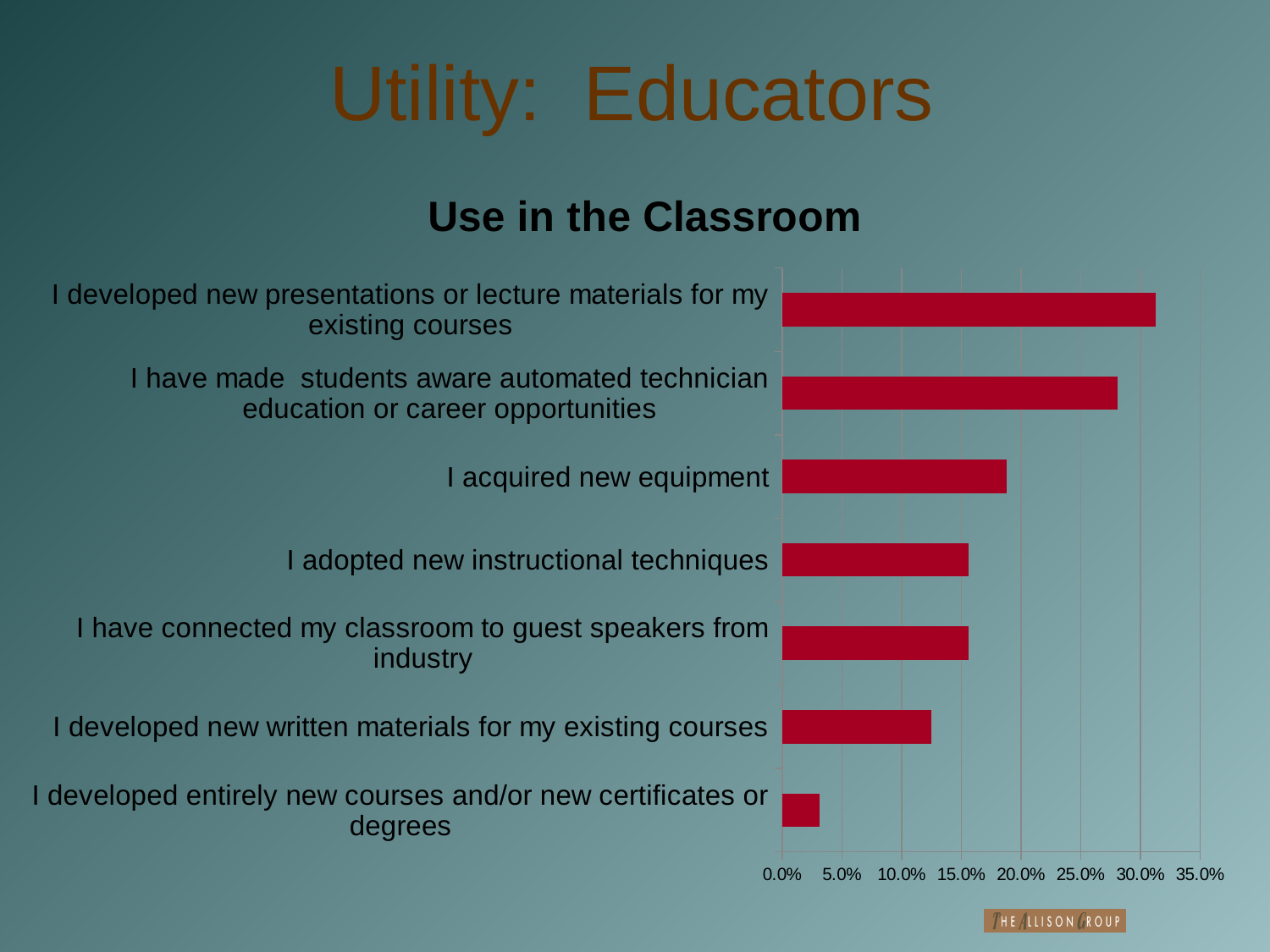
Is the value for "I developed new written materials for my existing courses" greater or less than 15.0%? less Is the value for "I developed entirely new courses and/or new certificates or degrees" greater or less than 5.0%? less What is the title of the chart? Use in the Classroom What is the maximum value shown on the horizontal axis? 35.0% Which category has the lowest value? I developed entirely new courses and/or new certificates or degrees Which is larger: the value for "I acquired new equipment" or the value for "I developed new written materials for my existing courses"? I acquired new equipment What kind of chart is shown on the slide? bar chart How many categories (bars) does the chart show? 7 Is the value for "I acquired new equipment" greater or less than 20.0%? less Which category has the highest value? I developed new presentations or lecture materials for my existing courses